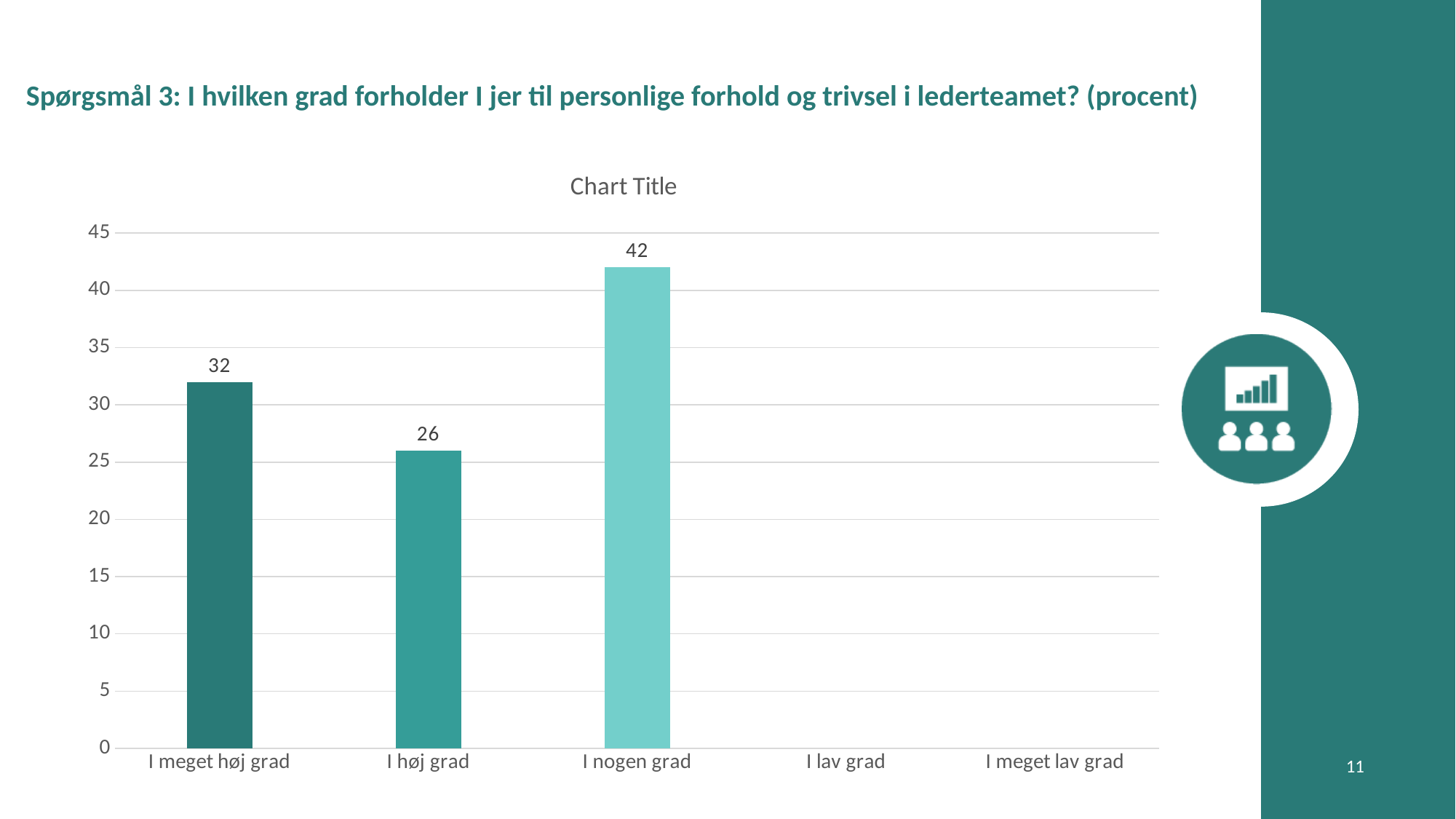
How many categories are shown on the x axis? 5 What is the difference between the values for "I meget høj grad" and "I høj grad"? 6 What kind of chart is shown on the slide? Bar chart Among the categories with visible bars, which has the lowest value? I høj grad What is the value for "I nogen grad"? 42 What is the difference between the values for "I nogen grad" and "I meget høj grad"? 10 Which category has the highest value? I nogen grad Which is larger, the value for "I meget høj grad" or the value for "I høj grad"? I meget høj grad What is the value for "I høj grad"? 26 Is the value for "I nogen grad" greater or less than 40? greater What is the value for "I meget høj grad"? 32 What is the title printed above the chart? Chart Title